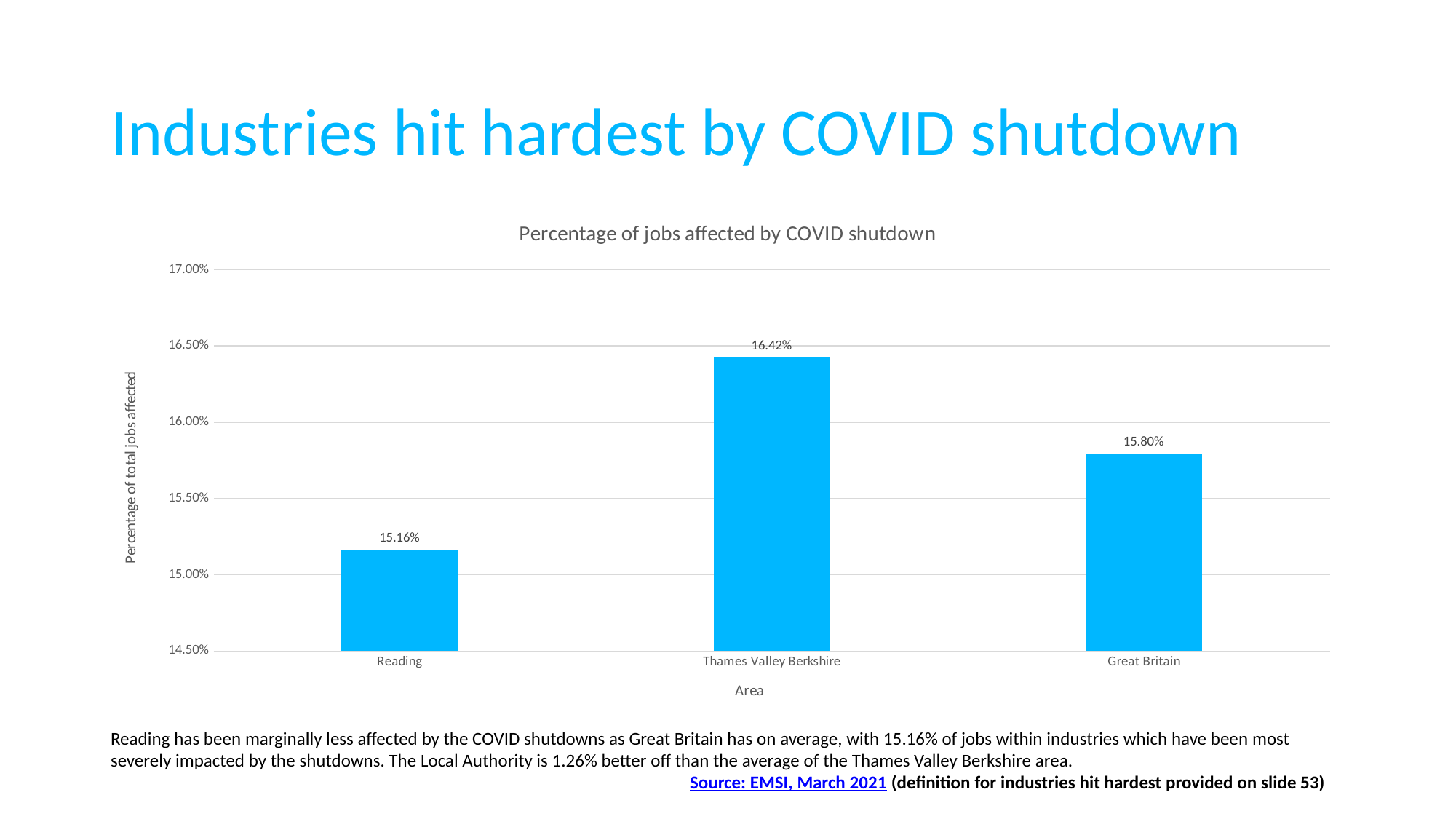
What is the difference in percentage points between Great Britain and Reading? 0.64% What is the percentage of jobs affected by COVID shutdown for Great Britain? 15.80% Is the value for Thames Valley Berkshire greater or less than 16.00%? greater Which area has the lowest percentage of jobs affected by COVID shutdown? Reading What is the percentage of jobs affected by COVID shutdown for Thames Valley Berkshire? 16.42% Which has a higher percentage of jobs affected, Great Britain or Reading? Great Britain What is the difference in percentage points between Thames Valley Berkshire and Reading? 1.26% What kind of chart is shown on the slide? Bar chart Which area has the highest percentage of jobs affected by COVID shutdown? Thames Valley Berkshire What is the title of the chart? Percentage of jobs affected by COVID shutdown What is the percentage of jobs affected by COVID shutdown for Reading? 15.16% How many areas are shown in the chart? 3